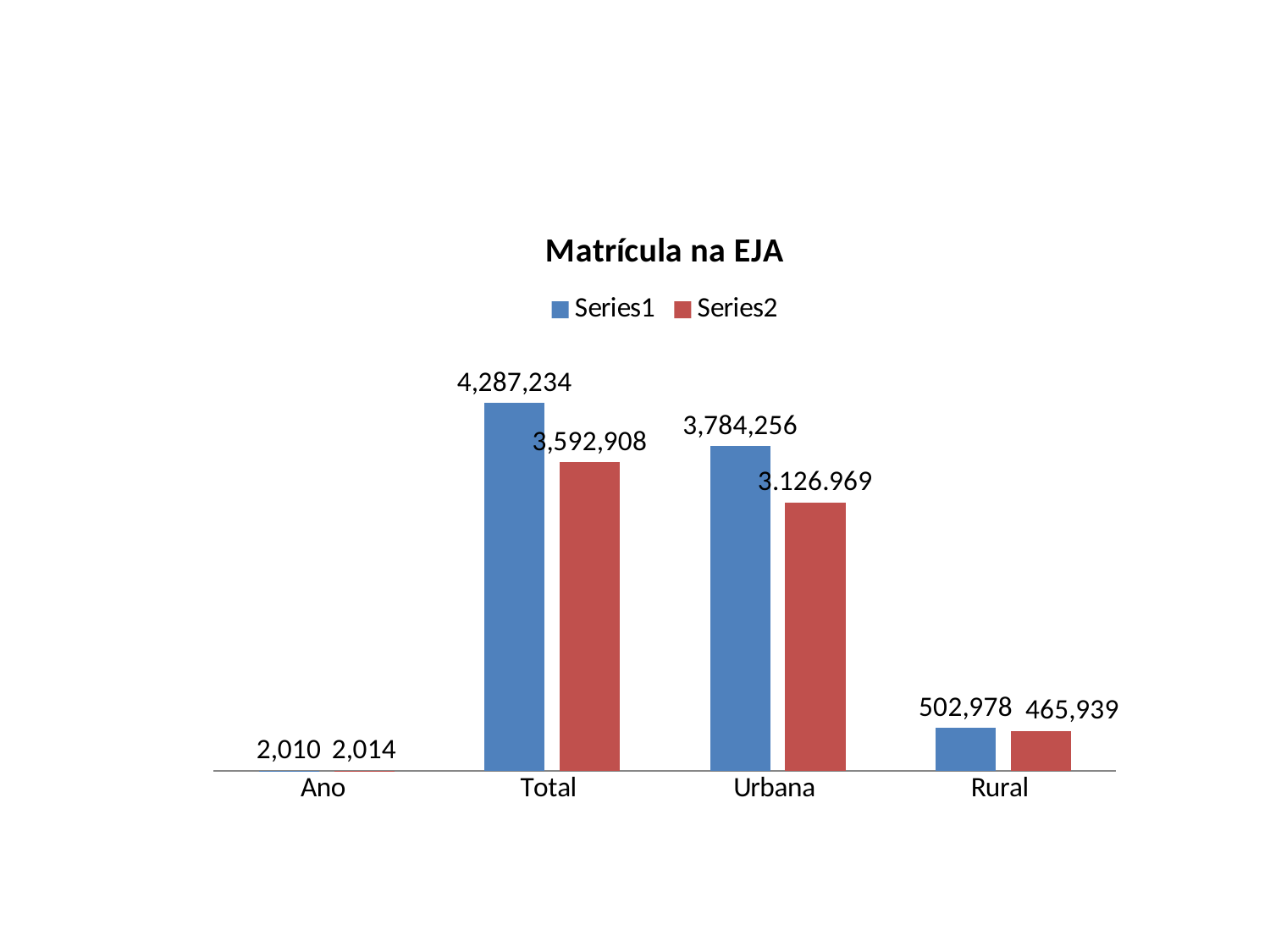
What kind of chart is shown on the slide? bar chart What is the difference between the Series1 and Series2 values for Total? 694,326 How many series does the legend list? 2 Which category has the highest Series1 value? Total What is the Series2 value for Rural? 465,939 Which is larger for Urbana, the Series1 value or the Series2 value? Series1 What is the title of the chart? Matrícula na EJA What is the difference between the Series1 and Series2 values for Rural? 37,039 How many categories are shown on the x axis? 4 What is the Series1 value for Urbana? 3,784,256 What is the Series2 value for Total? 3,592,908 What is the Series1 value for Total? 4,287,234